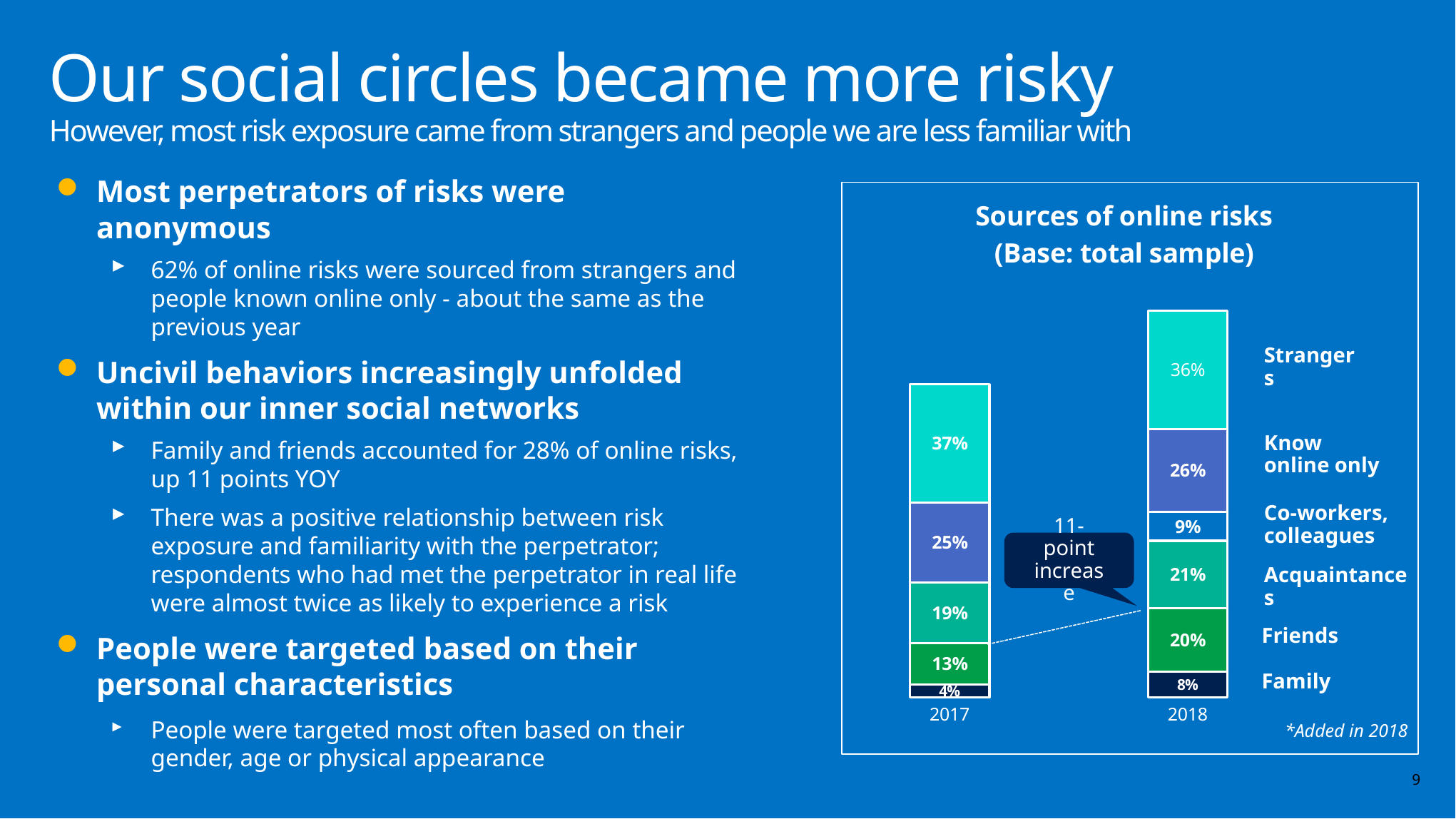
In the Sources of online risks chart, which source had the smallest share in 2017? Family In the Sources of online risks chart, what percentage of online risks came from Strangers in 2018? 36% In the Sources of online risks chart, what percentage of online risks came from Family in 2017? 4% In the Sources of online risks chart, what is the value for Friends in 2018? 20% In the Sources of online risks chart, by how many percentage points did the Acquaintances share change from 2017 to 2018? 2 percentage points How many years (bars) are shown in the Sources of online risks chart? 2 In the Sources of online risks chart, what is the value for Co-workers, colleagues in 2018? 9% How many source categories does the legend of the Sources of online risks chart list? 6 In the Sources of online risks chart, was the Strangers share larger in 2017 or 2018? 2017 In the Sources of online risks chart, by how many percentage points did the Friends share change from 2017 to 2018? 7 percentage points In the Sources of online risks chart, what is the value for Know online only in 2017? 25% In the Sources of online risks chart, which source had the largest share in 2018? Strangers